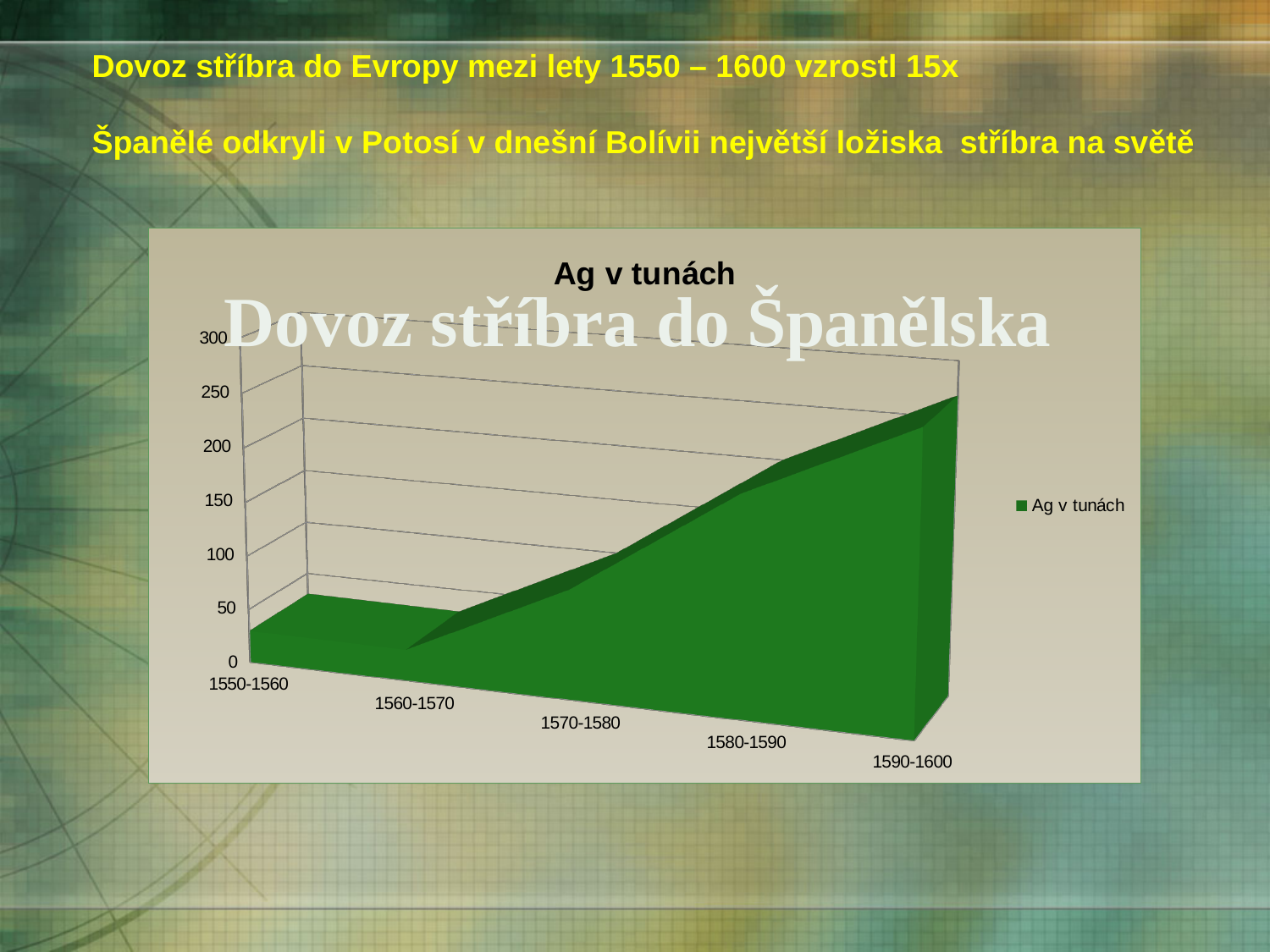
How many series does the chart legend list? 1 What is the name of the series shown in the chart legend? Ag v tunách Is the value for 1580-1590 greater or less than 100? greater Is the value for 1550-1560 greater or less than 50? less Do the values rise or fall along the x axis from 1550-1560 to 1590-1600? rise Which period has the highest value in the chart? 1590-1600 What is the title printed above the chart's plot area? Ag v tunách What kind of chart is shown on the slide? area chart How many time periods are shown on the x axis of the chart? 5 Is the value for 1570-1580 greater or less than 150? less Which has the larger value, 1570-1580 or 1580-1590? 1580-1590